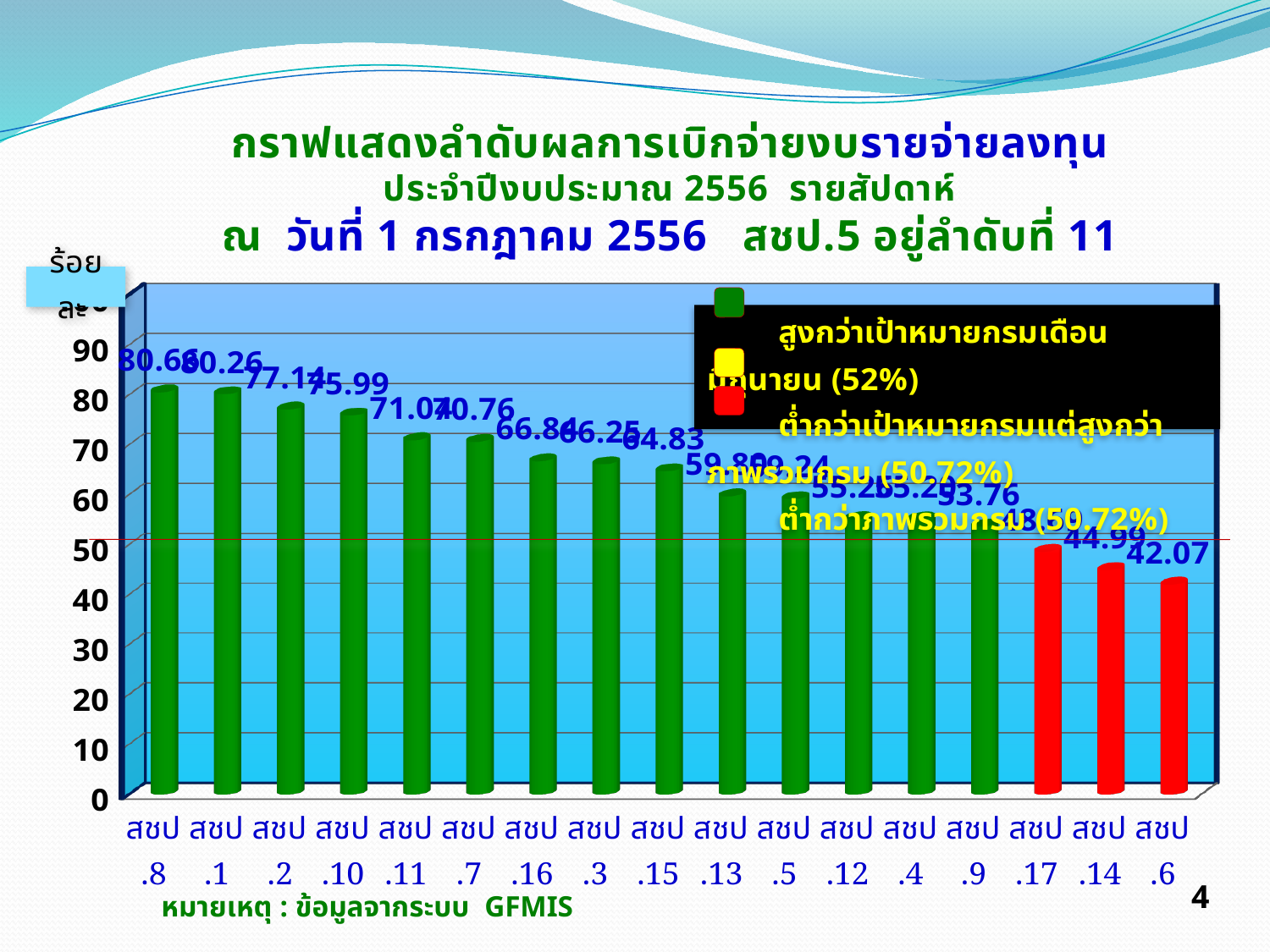
What is the difference between the values for สชป.2 and สชป.10? 1.15 Which is larger, the value for สชป.9 or the value for สชป.14? สชป.9 What kind of chart is shown on the slide? bar chart What is the difference between the values for สชป.14 and สชป.6? 2.92 What is the value for สชป.2? 77.14 Which category has the lowest value? สชป.6 What is the value for สชป.6? 42.07 How many categories are shown on the x axis? 17 What is the value for สชป.11? 71.04 Is the value for สชป.17 greater or less than 50? less What is the value for สชป.15? 64.83 Do the values rise or fall from left to right along the x axis? fall